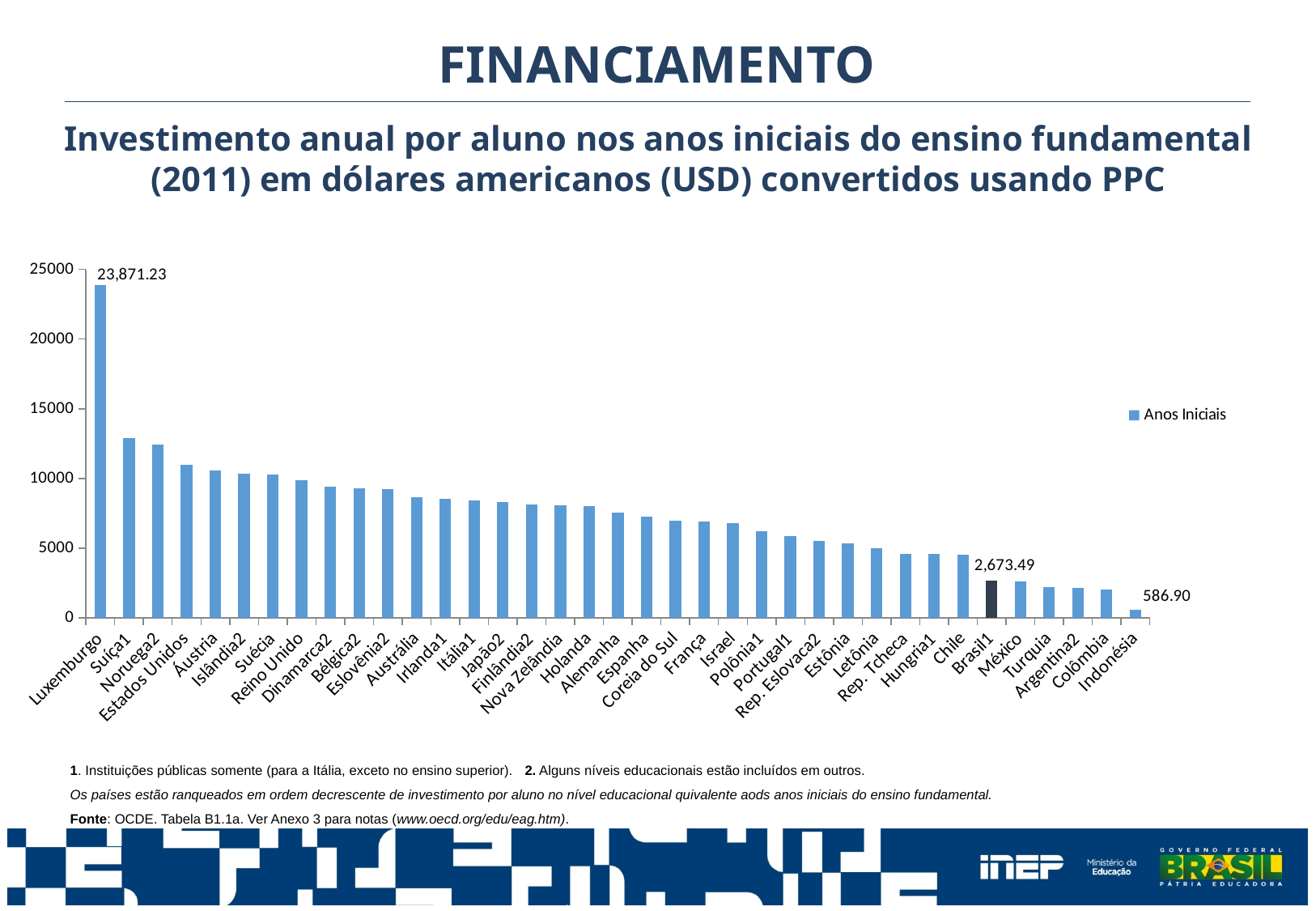
What is the value for Brasil1? 2,673.49 What is the value for Indonésia? 586.90 What is the difference between the values for Brasil1 and Indonésia? 2,086.59 Which country has the highest value? Luxemburgo Is the value for Suíça1 greater or less than 10000? greater What is the value for Luxemburgo? 23,871.23 What is the difference between the values for Luxemburgo and Brasil1? 21,197.74 Which country has the lowest value? Indonésia Do the values rise or fall from left to right along the x axis? fall Is the value for Turquia greater or less than 5000? less How many countries are shown on the x axis? 37 Which has a larger value, Chile or Brasil1? Chile